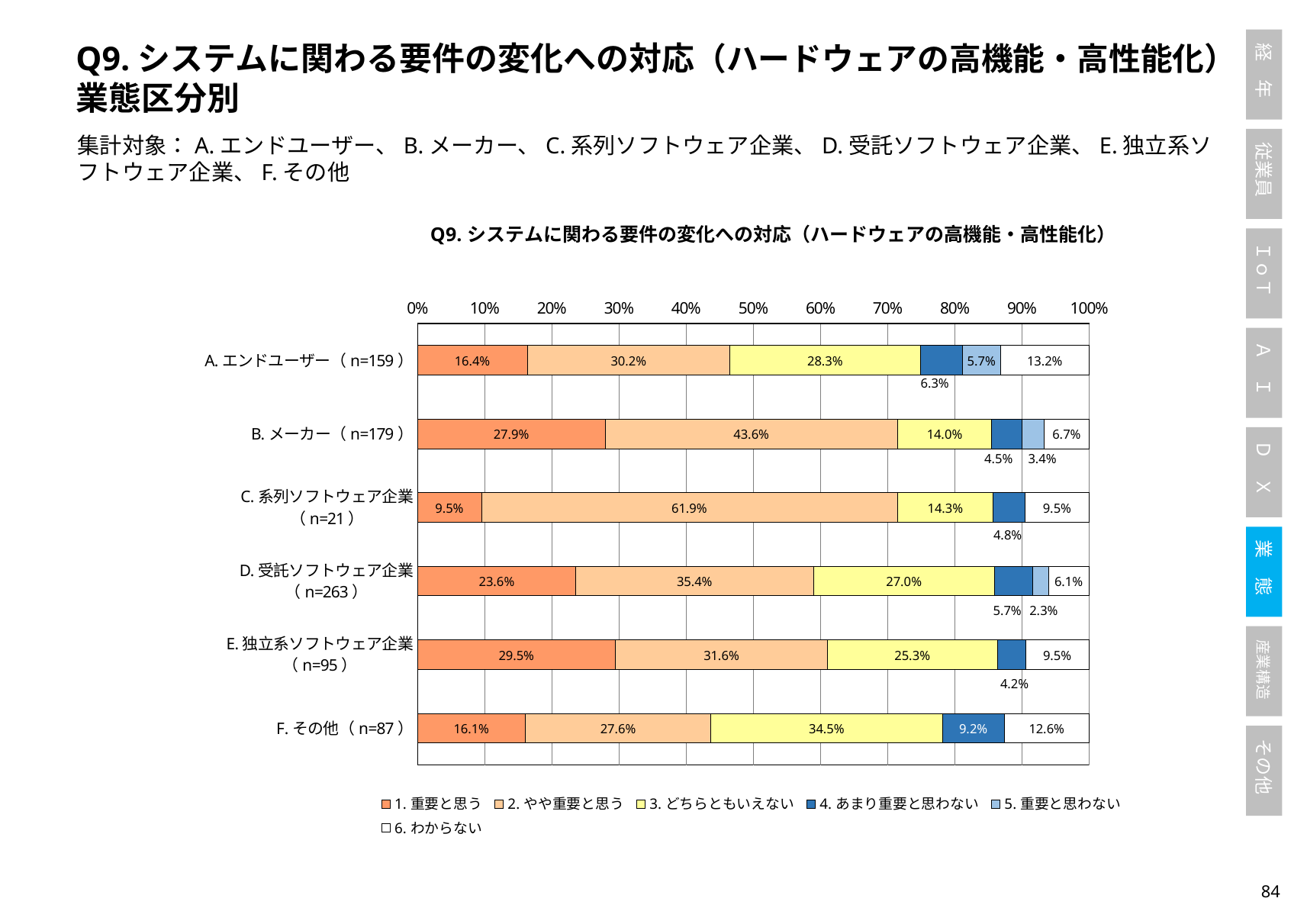
What is the value of 6. わからない for B. メーカー? 6.7% What is the sample size (n) shown for D. 受託ソフトウェア企業? 263 Which category has the highest value for 1. 重要と思う? E. 独立系ソフトウェア企業 How many categories (business types) are shown on the chart? 6 Which category has the lowest value for 1. 重要と思う? C. 系列ソフトウェア企業 What kind of chart is shown on the slide? Stacked bar chart Which has a larger value for 3. どちらともいえない, D. 受託ソフトウェア企業 or E. 独立系ソフトウェア企業? D. 受託ソフトウェア企業 What percentage of A. エンドユーザー respondents answered 1. 重要と思う? 16.4% How many series does the legend list? 6 What is the value of 2. やや重要と思う for C. 系列ソフトウェア企業? 61.9% What percentage of F. その他 respondents answered 3. どちらともいえない? 34.5% What is the difference in percentage points between the 2. やや重要と思う values for B. メーカー and A. エンドユーザー? 13.4